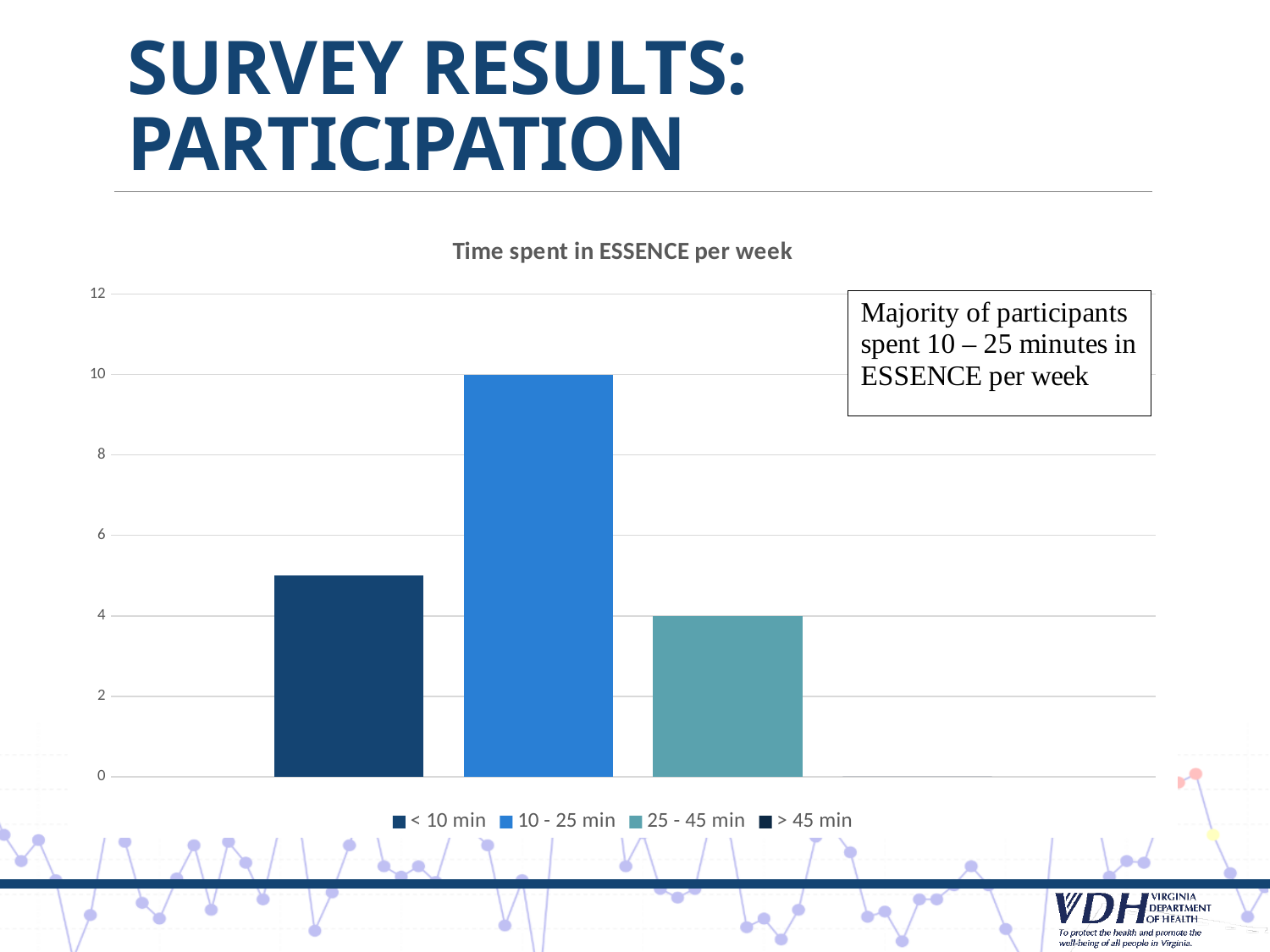
What is the title of the chart? Time spent in ESSENCE per week How many entries does the chart legend list? 4 How many bars are visible in the chart? 3 What is the value for the 25 - 45 min category? 4 What is the value for the 10 - 25 min category? 10 Is the value for < 10 min greater or less than 4? greater What is the difference between the values for 10 - 25 min and 25 - 45 min? 6 Of the three visible bars, which category has the shortest bar? 25 - 45 min Is the value for < 10 min greater or less than 6? less Which category has the tallest bar? 10 - 25 min Which is larger, the value for < 10 min or the value for 25 - 45 min? < 10 min What kind of chart is shown on the slide? bar chart